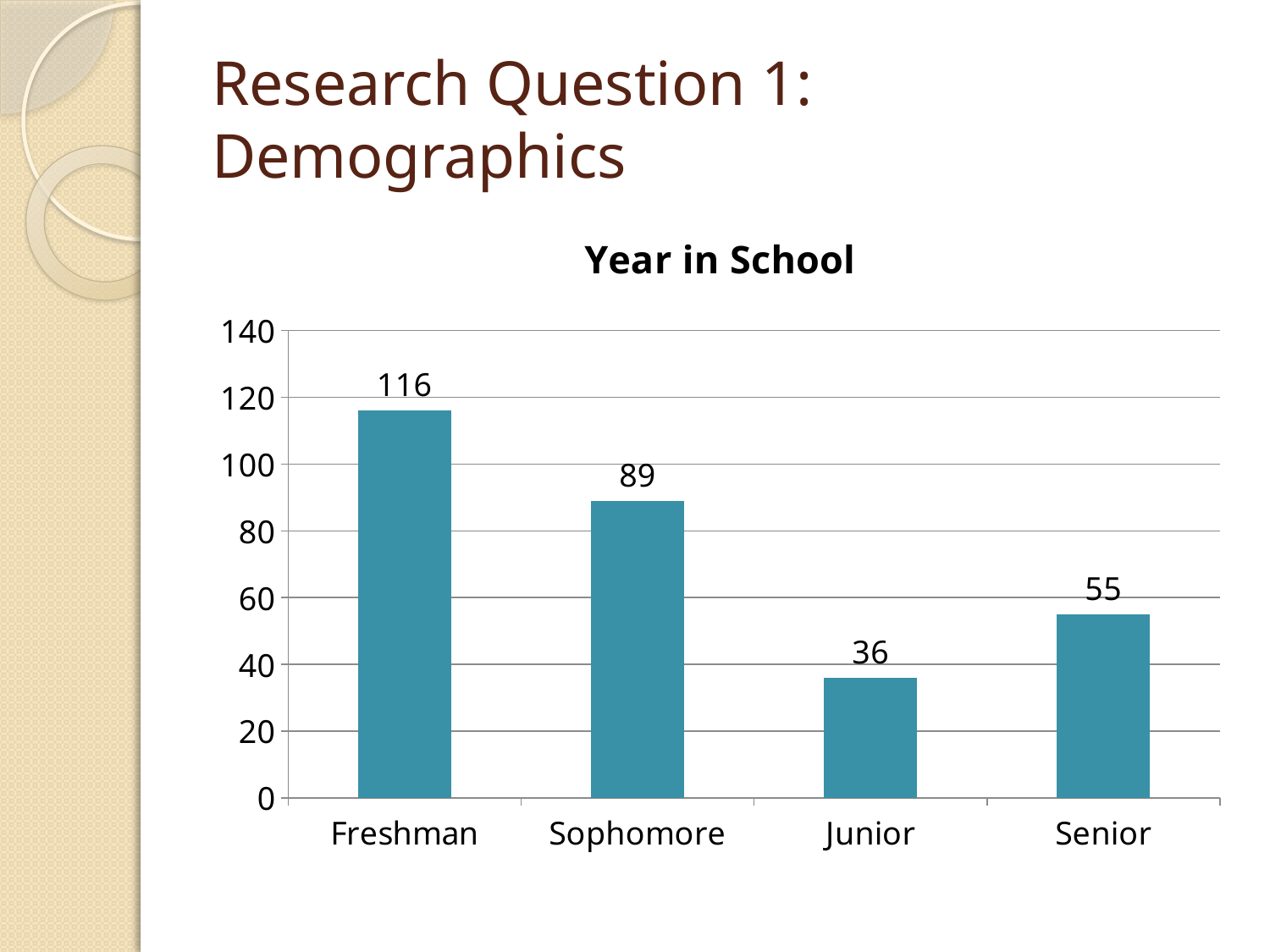
Which is larger, the value for Sophomore or the value for Senior? Sophomore What is the value for Senior? 55 What is the difference between the values for Freshman and Sophomore? 27 What is the value for Junior? 36 What is the difference between the values for Senior and Junior? 19 What is the value for Freshman? 116 Which category has the lowest value? Junior What type of chart is shown on the slide? bar chart Is the value for Freshman greater or less than 100? greater How many categories are shown on the x axis? 4 What is the value for Sophomore? 89 Which category has the highest value? Freshman